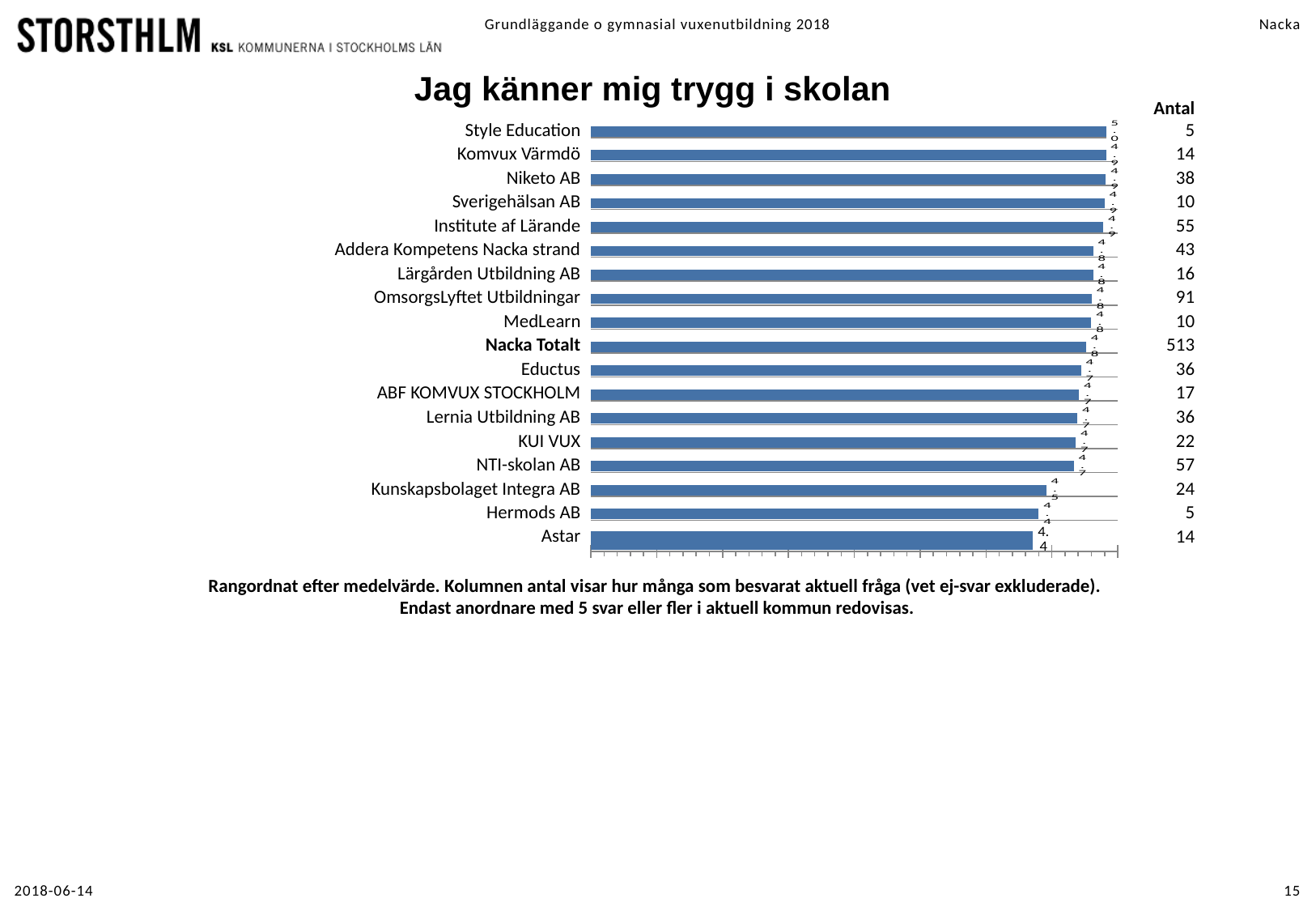
What is the Antal (number of respondents) listed for Niketo AB? 38 What is the title of the chart? Jag känner mig trygg i skolan What kind of chart is shown on the slide? bar chart What is the difference between the values for Style Education and Astar? 0.6 What is the value shown for Astar? 4.4 What is the value shown for Kunskapsbolaget Integra AB? 4.5 Do the bar values increase or decrease going from the top of the chart to the bottom? decrease What is the value shown for Style Education? 5.0 Which has a larger value, NTI-skolan AB or Kunskapsbolaget Integra AB? NTI-skolan AB What is the Antal (number of respondents) listed for Nacka Totalt? 513 Which category has the highest value in the chart? Style Education How many categories (providers) are shown in the chart? 18